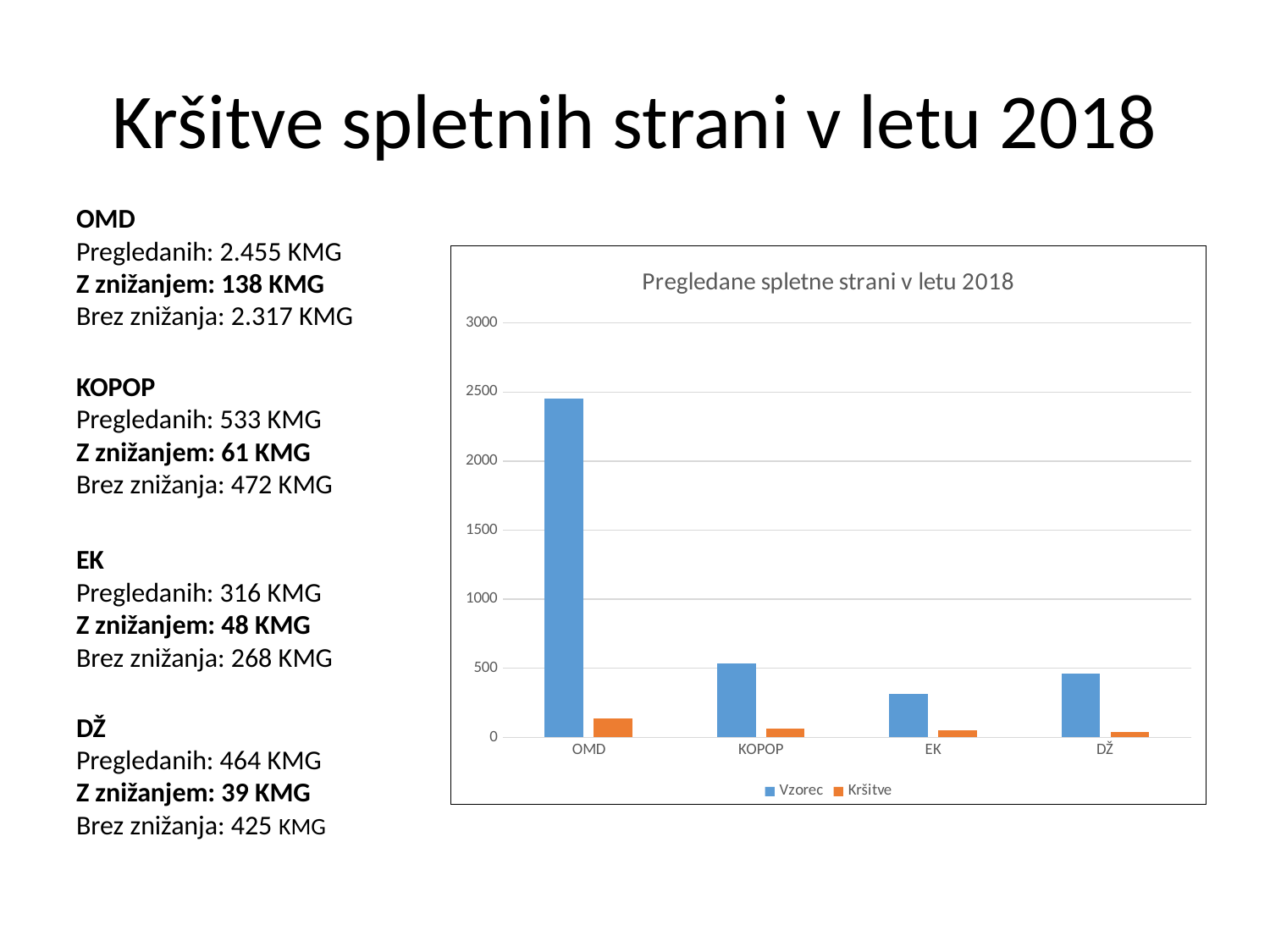
Which category has the highest Kršitve value? OMD What is the title of the chart? Pregledane spletne strani v letu 2018 Is the Vzorec value for OMD greater or less than 2000? greater Is the Vzorec value for DŽ greater or less than 500? less Which category has the highest Vzorec value? OMD Which is larger, the Vzorec value for KOPOP or the Vzorec value for EK? KOPOP What kind of chart is shown on the slide? bar chart How many categories are shown on the x axis of the chart? 4 What are the two series named in the chart legend? Vzorec and Kršitve Which category has the lowest Vzorec value? EK How many series does the chart legend list? 2 Is the Vzorec value for KOPOP greater or less than 1000? less